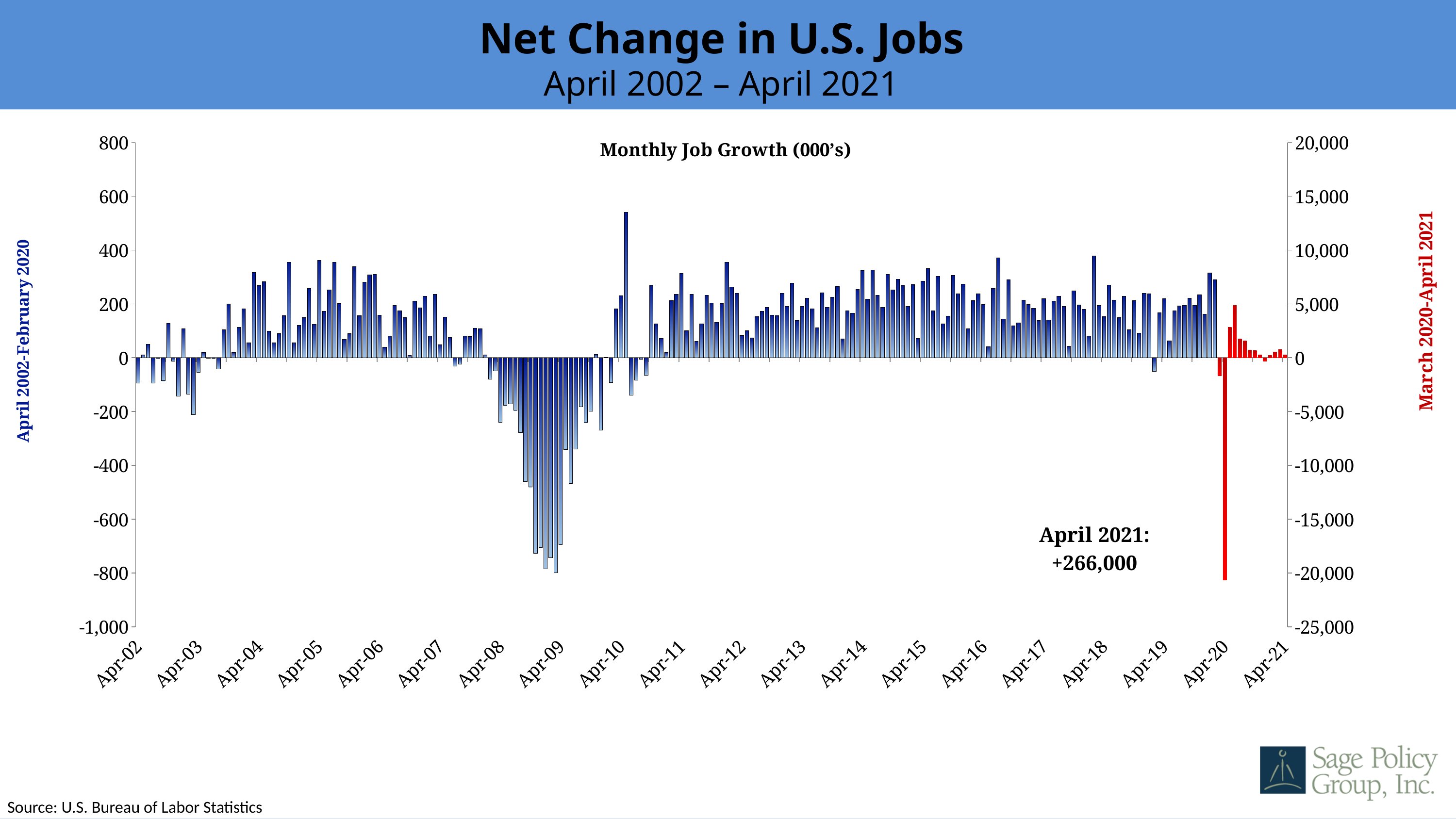
What is the net change in U.S. jobs for April 2021 as printed on the chart? +266,000 Between Apr-08 and Apr-09, do the monthly values generally rise or fall? fall Is the value of the lowest red bar, near Apr-20, greater or less than -15,000 on the right axis? less What is the title of the chart on the slide? Monthly Job Growth (000’s) Which axis do the red bars (March 2020-April 2021) use, the left or the right? right How many year labels are shown along the x axis, from Apr-02 to Apr-21? 20 Near which x-axis label does the tallest blue bar appear? Apr-10 What kind of chart is shown on the slide? bar chart Is the value of the blue bar at Apr-02 greater or less than 0? less Is the value of the lowest blue bar, near Apr-09, greater or less than -600 on the left axis? less Near which x-axis label does the lowest bar on the whole chart appear? Apr-20